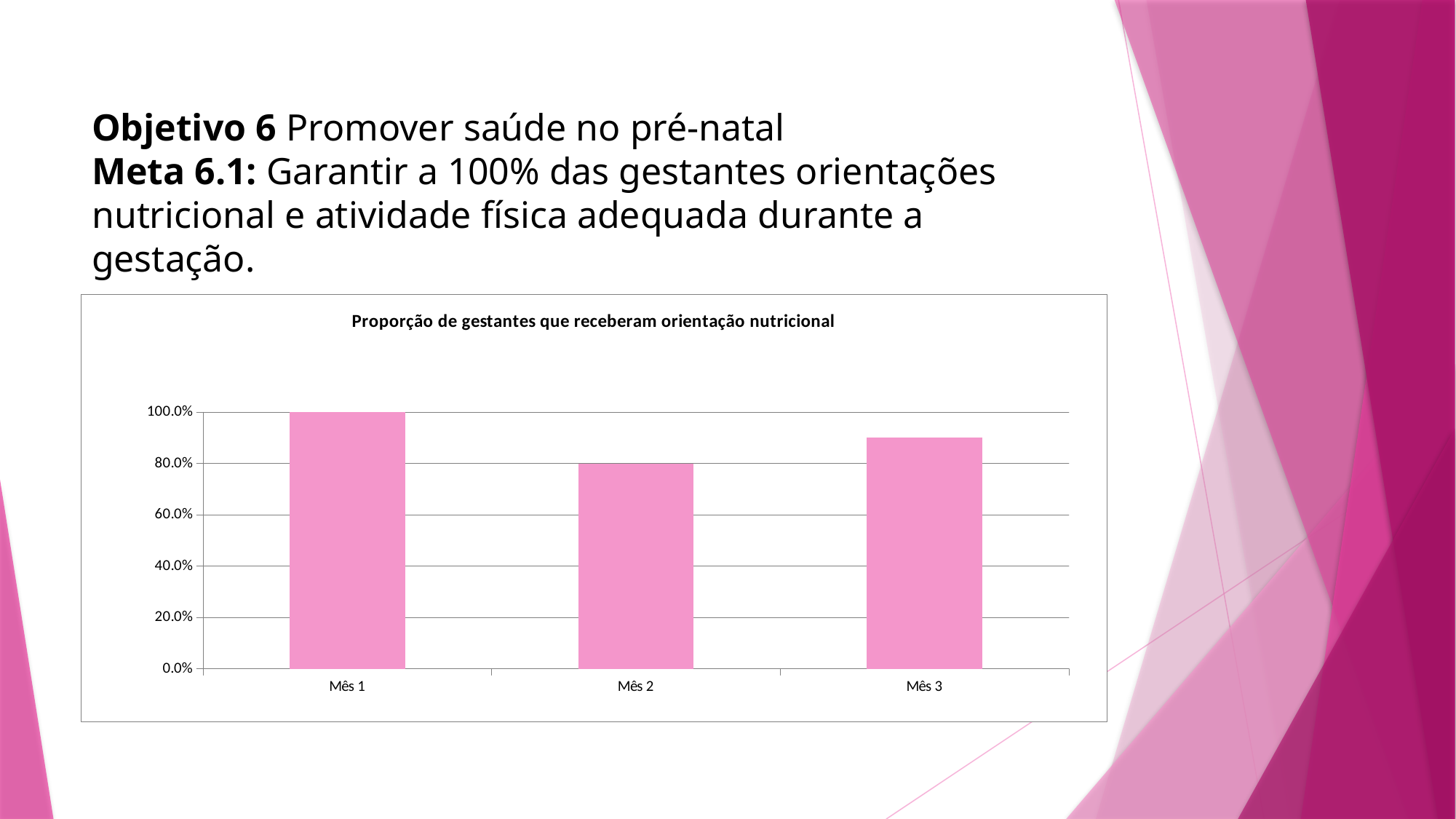
Does the value rise or fall from Mês 1 to Mês 2? fall Is the value for Mês 3 greater or less than 100.0%? less What is the difference between the values for Mês 1 and Mês 2? 20.0% Which is larger, the value for Mês 3 or the value for Mês 2? Mês 3 What is the title of the chart? Proporção de gestantes que receberam orientação nutricional Which month has the lowest value? Mês 2 What is the value for Mês 2? 80.0% Is the value for Mês 3 greater or less than 80.0%? greater What is the value for Mês 1? 100.0% Which month has the highest value? Mês 1 What type of chart is shown on the slide? Bar chart How many categories (months) are plotted in the chart? 3